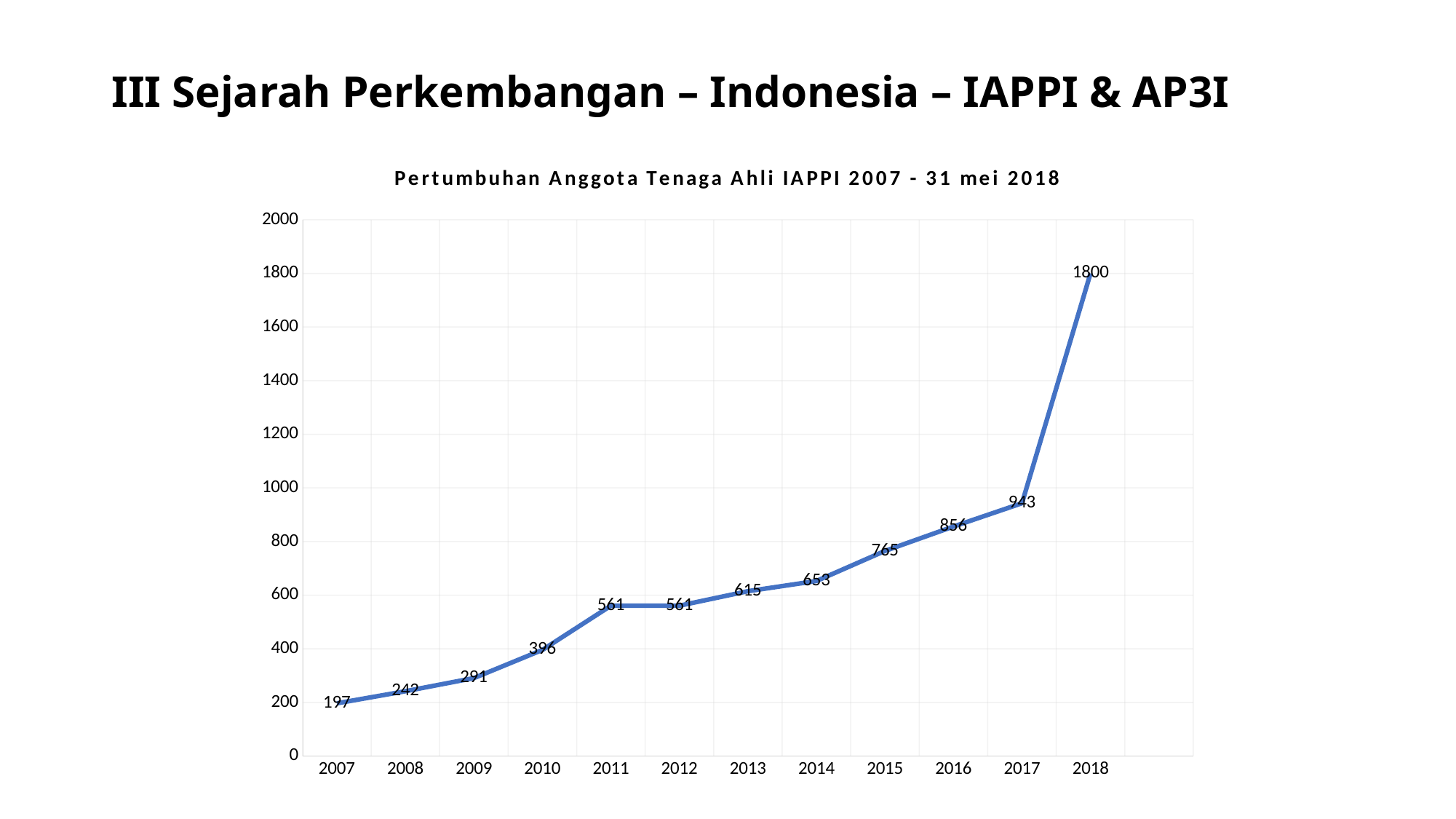
What is the value for 2018? 1800 What is the value for 2007? 197 How many years are plotted on the x axis? 12 Is the value for 2016 greater or less than 1000? less Do the values rise or fall from 2007 to 2018? rise Which year has the lowest value? 2007 Which is larger, the value for 2010 or the value for 2009? 2010 What is the value for 2014? 653 What kind of chart is shown? line chart What is the difference between the values for 2018 and 2017? 857 Which year has the highest value? 2018 What is the title of the chart? Pertumbuhan Anggota Tenaga Ahli IAPPI 2007 - 31 mei 2018